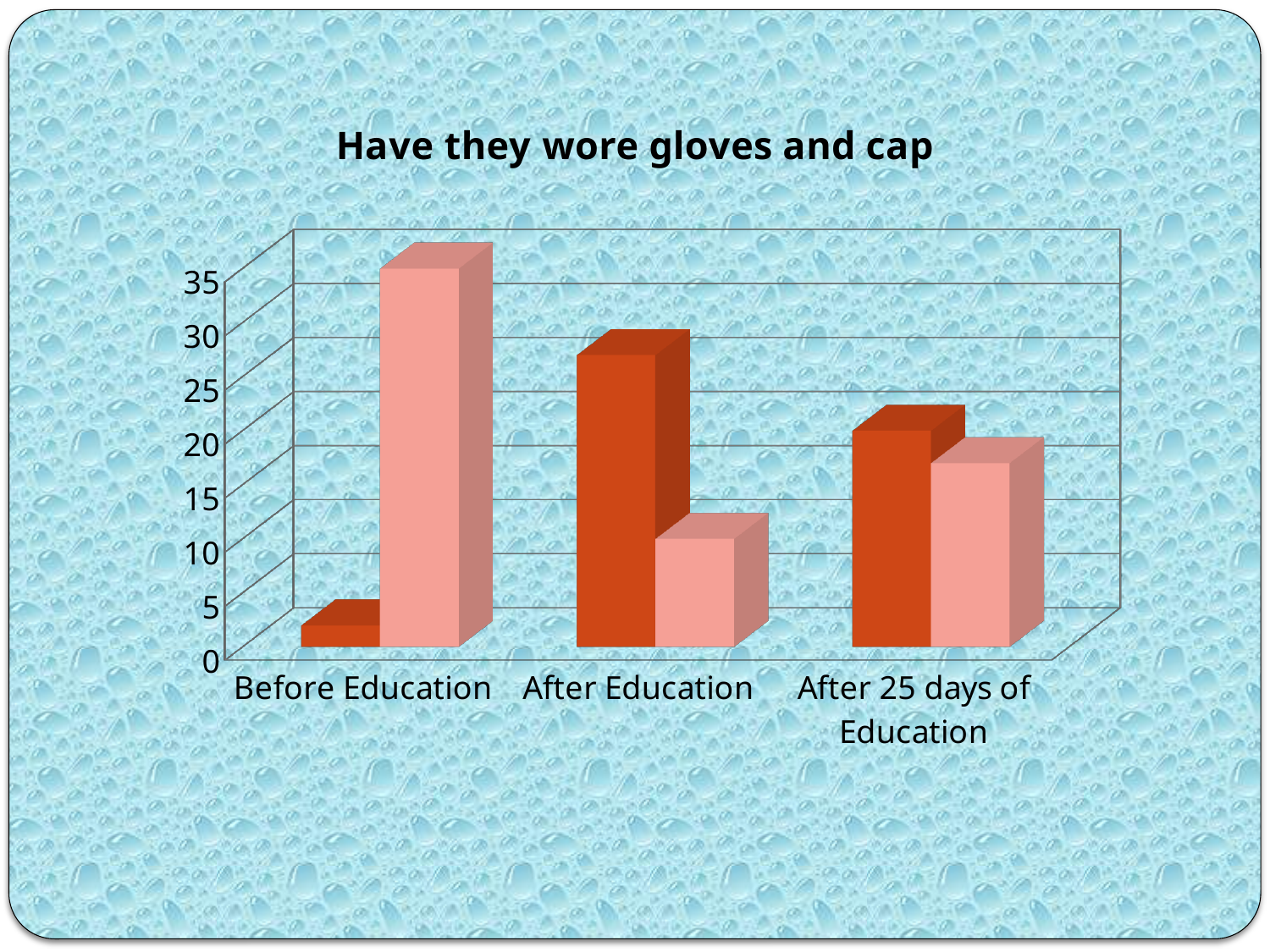
Is the value of the light pink bar for Before Education greater or less than 30? greater For After Education, which bar is taller, the dark orange bar or the light pink bar? the dark orange bar What is the title of the chart? Have they wore gloves and cap Is the value of the dark orange bar for After Education greater or less than 20? greater How many categories are shown on the x axis of the chart? 3 Which category has the tallest dark orange bar? After Education How many bars are plotted for each category in the chart? 2 What kind of chart is shown on the slide? bar chart Is the value of the light pink bar for After Education greater or less than 15? less Which category has the shortest light pink bar? After Education For Before Education, which bar is taller, the dark orange bar or the light pink bar? the light pink bar